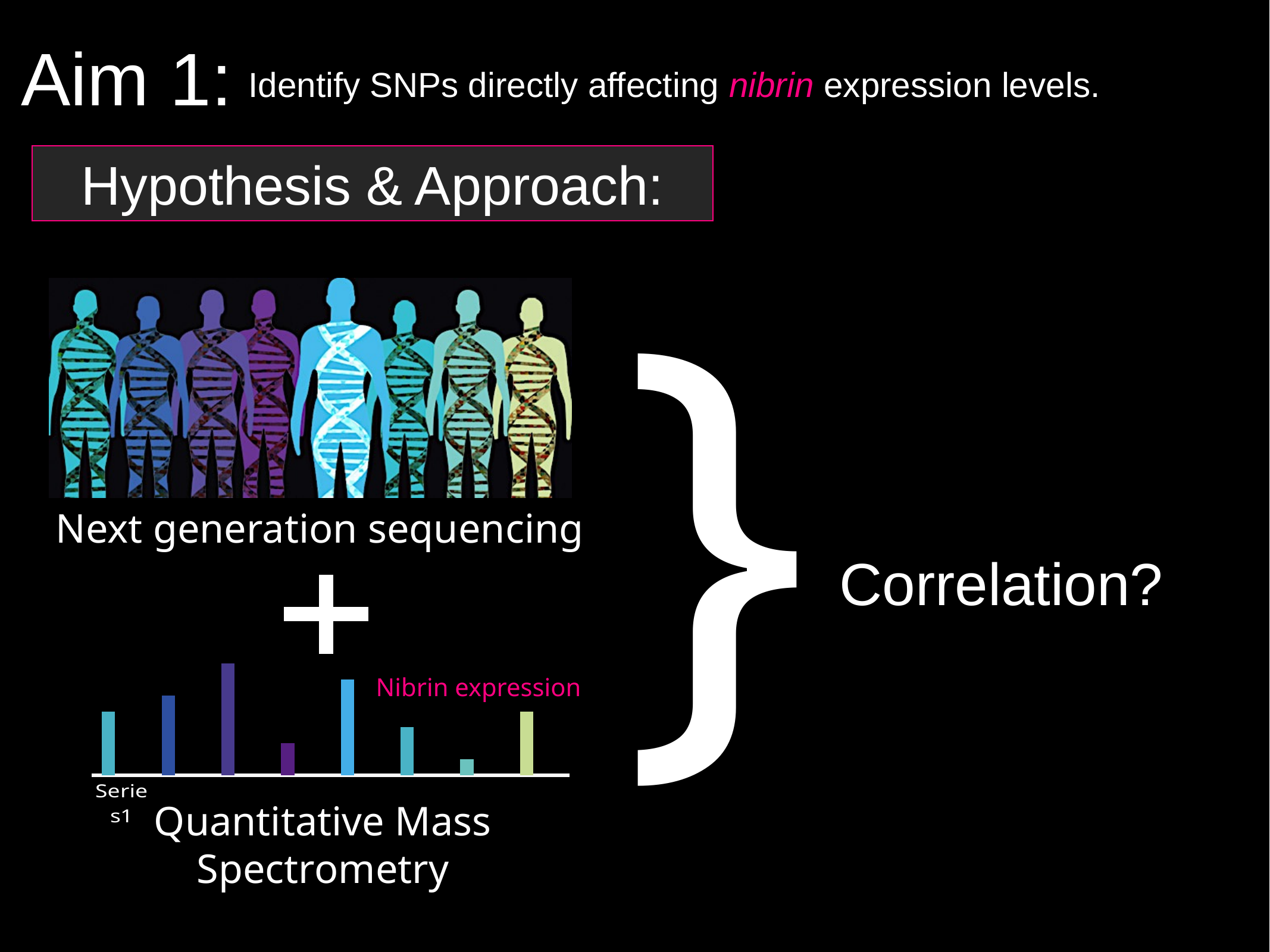
In the bar chart, is the second bar from the left taller or shorter than the sixth bar? taller Which bar in the bar chart is the tallest, counting from the left? the third bar What title is written in pink above the bar chart? Nibrin expression What kind of chart is shown at the bottom left of the slide? bar chart In the bar chart, which is taller: the fifth bar or the seventh bar from the left? the fifth bar Which bar in the bar chart is the shortest, counting from the left? the seventh bar How many bars does the bar chart contain? 8 In the bar chart, is the first bar from the left taller or shorter than the fourth bar? taller What series label appears below the left end of the bar chart's axis? Series1